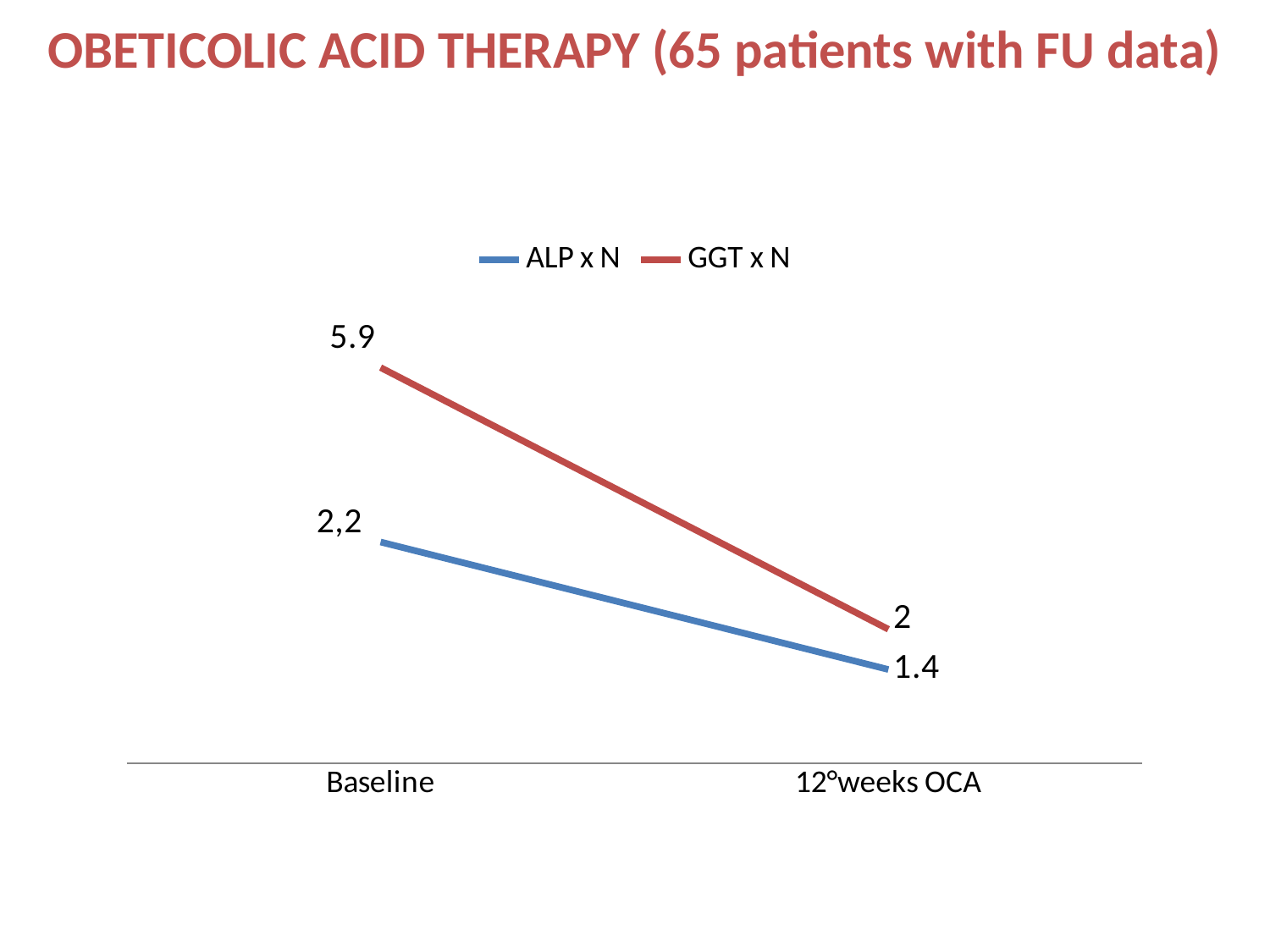
Which series has the higher value at Baseline, ALP x N or GGT x N? GGT x N How many categories are shown on the x axis? 2 What kind of chart is shown on the slide? line chart Does the ALP x N series rise or fall from Baseline to 12°weeks OCA? fall What is the difference between GGT x N and ALP x N at 12°weeks OCA? 0.6 What is the value of GGT x N at 12°weeks OCA? 2 How many series does the legend list? 2 What is the value of ALP x N at Baseline? 2,2 By how much does GGT x N decrease from Baseline to 12°weeks OCA? 3.9 What is the value of ALP x N at 12°weeks OCA? 1.4 What is the value of GGT x N at Baseline? 5.9 Which series has the lower value at 12°weeks OCA? ALP x N